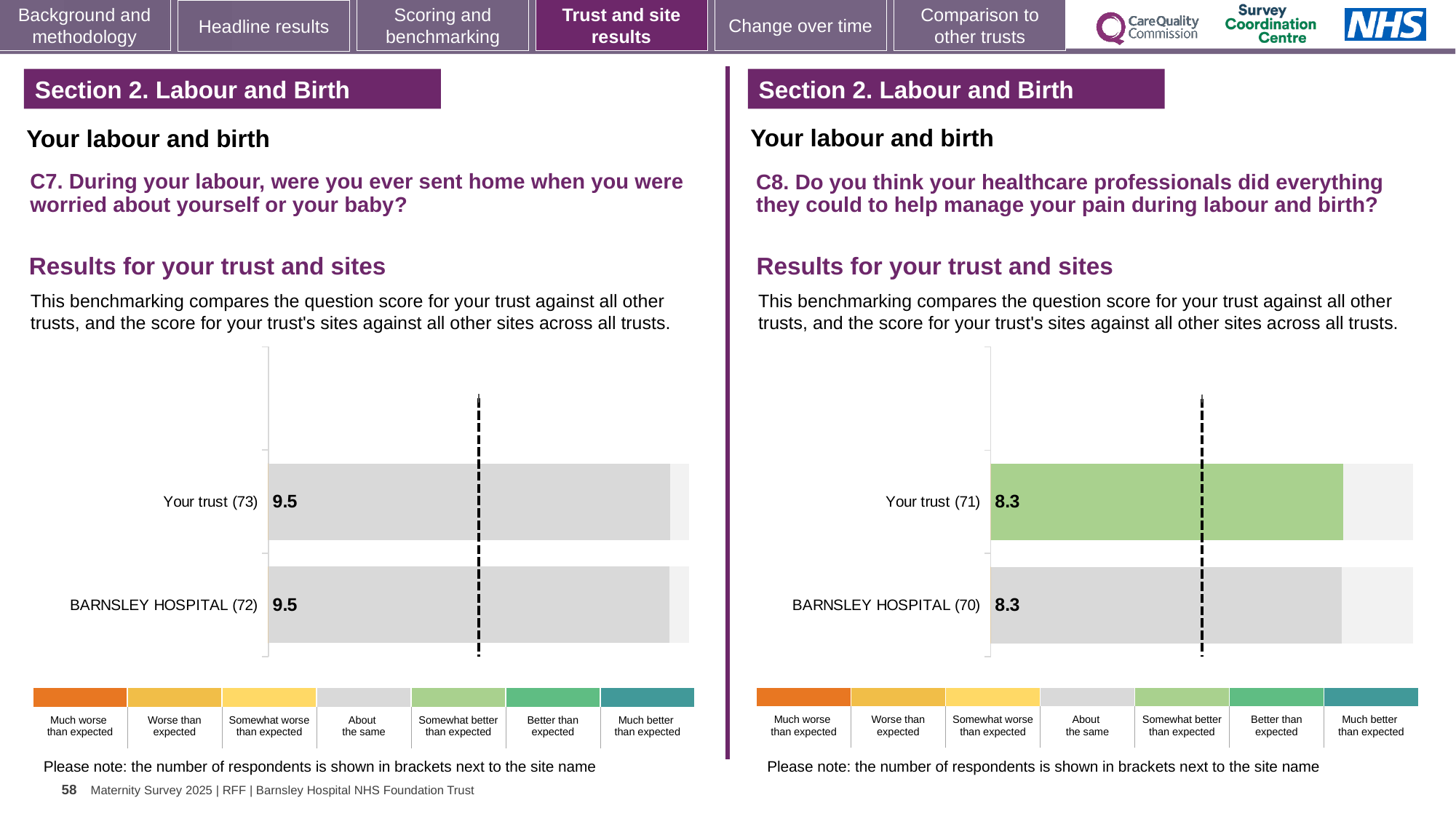
In the right chart (C8), which benchmark category does the green colour of the Your trust bar correspond to? Somewhat better than expected In the right chart (C8), how many respondents are shown in brackets for BARNSLEY HOSPITAL? 70 In the left chart (C7), what is the score for Your trust? 9.5 What kind of chart is used on the right side of the slide (C8)? Bar chart In the left chart (C7), what is the difference between the score for Your trust and the score for BARNSLEY HOSPITAL? 0 In the left chart (C7), which benchmark category does the grey colour of the bars correspond to? About the same In the left chart (C7), how many respondents are shown in brackets for Your trust? 73 In the right chart (C8), what is the score for Your trust? 8.3 In the left chart (C7), what is the score for BARNSLEY HOSPITAL? 9.5 In the right chart (C8), what is the score for BARNSLEY HOSPITAL? 8.3 How many categories does the colour key below the right chart (C8) list? 7 How many bars are plotted in the left chart (C7)? 2